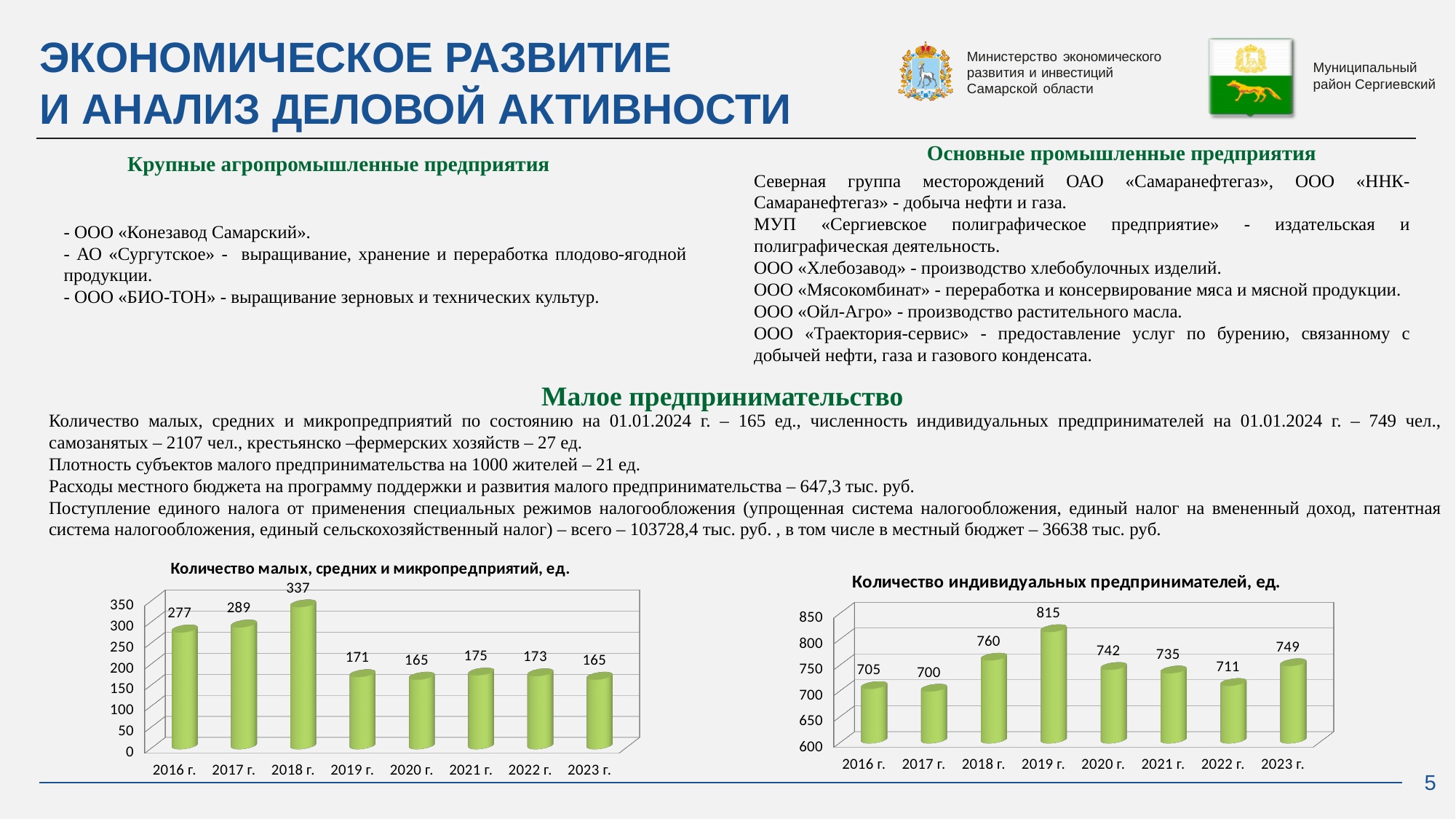
What kind of chart is "Количество индивидуальных предпринимателей, ед."? Bar chart In the chart "Количество индивидуальных предпринимателей, ед.", what is the difference between the values for 2019 г. and 2018 г.? 55 In the chart "Количество малых, средних и микропредприятий, ед.", what is the difference between the values for 2018 г. and 2019 г.? 166 In the chart "Количество индивидуальных предпринимателей, ед.", which year has the lowest value? 2017 г. In the chart "Количество малых, средних и микропредприятий, ед.", what is the value for 2018 г.? 337 In the chart "Количество малых, средних и микропредприятий, ед.", is the value for 2017 г. greater or less than 250? greater In the chart "Количество малых, средних и микропредприятий, ед.", which year has the lowest value? 2020 г. and 2023 г. (165) In the chart "Количество индивидуальных предпринимателей, ед.", which year has the highest value? 2019 г. In the chart "Количество малых, средних и микропредприятий, ед.", how many years are shown on the x axis? 8 In the chart "Количество индивидуальных предпринимателей, ед.", what is the value for 2023 г.? 749 In the chart "Количество индивидуальных предпринимателей, ед.", which is larger: the value for 2020 г. or 2022 г.? 2020 г. In the chart "Количество индивидуальных предпринимателей, ед.", do the values rise or fall from 2019 г. to 2022 г.? fall